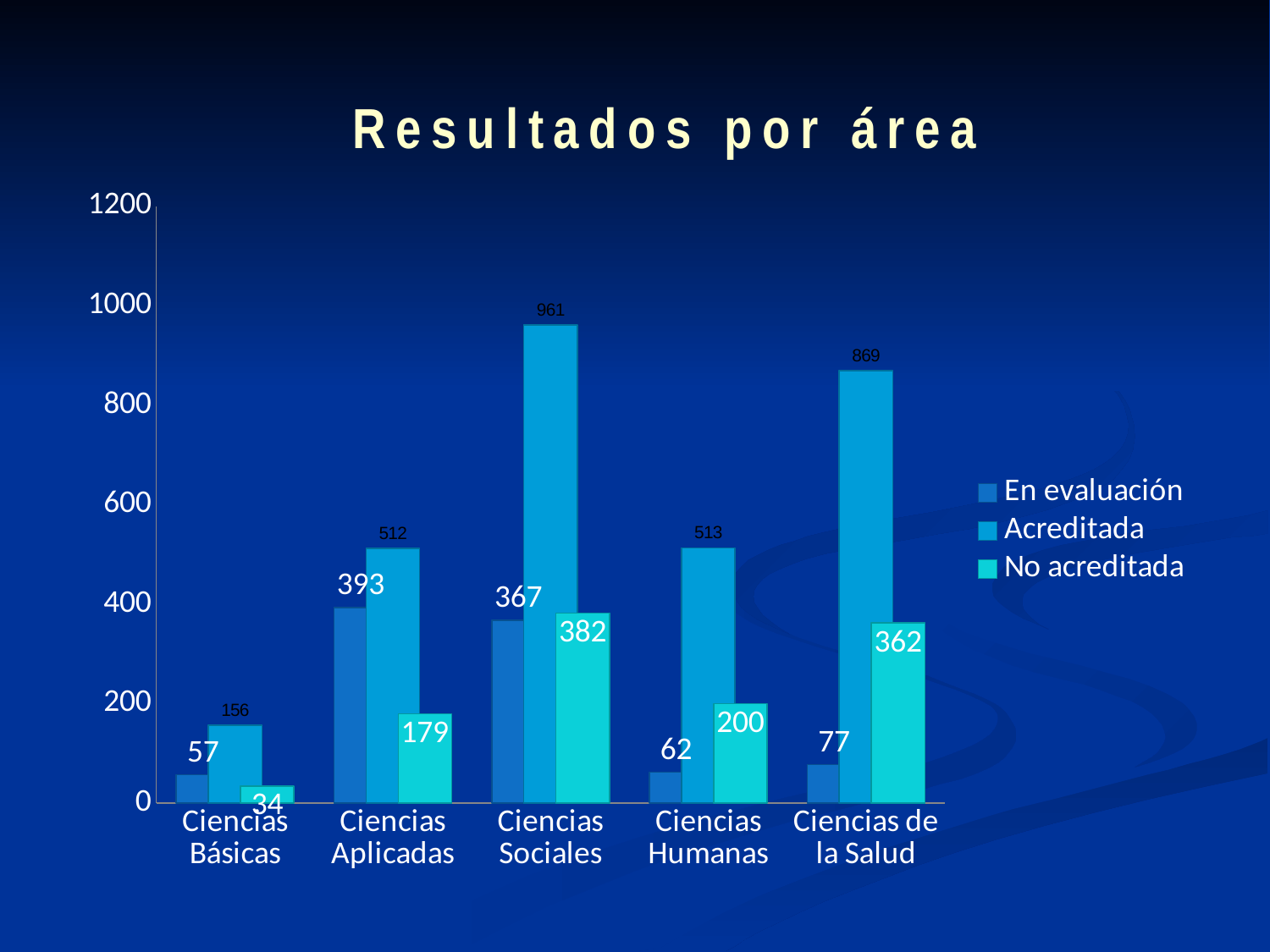
Which series is shown in the darkest blue colour? En evaluación What is the title of the chart? Resultados por área Which category has the highest Acreditada value? Ciencias Sociales What is the Acreditada value for Ciencias Sociales? 961 What is the difference between the Acreditada values for Ciencias Sociales and Ciencias de la Salud? 92 What type of chart is shown on the slide? bar chart How many categories are shown on the x axis? 5 Which is larger: the En evaluación value for Ciencias Aplicadas or for Ciencias Sociales? Ciencias Aplicadas How many series does the legend list? 3 What is the No acreditada value for Ciencias Humanas? 200 Which category has the lowest No acreditada value? Ciencias Básicas What is the En evaluación value for Ciencias de la Salud? 77